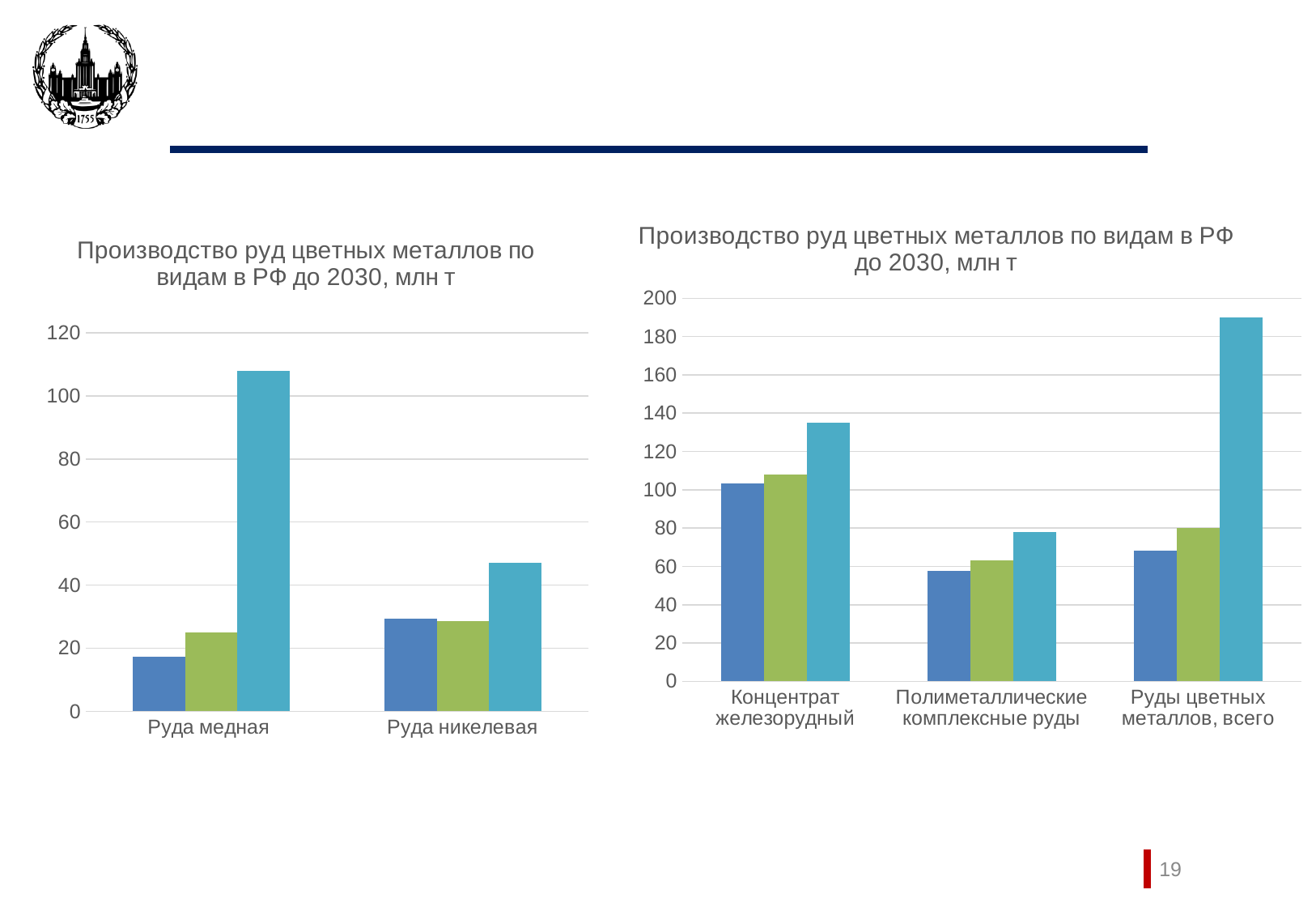
What kind of chart is the left chart on the slide? bar chart How many categories are shown on the x axis of the left chart? 2 In the right chart, which dark blue bar is larger: Концентрат железорудный or Полиметаллические комплексные руды? Концентрат железорудный How many bars are plotted for each category in the right chart? 3 How many categories are shown on the x axis of the right chart? 3 In the left chart, does the light blue bar rise or fall from Руда медная to Руда никелевая? fall In the left chart, is the value of the dark blue bar for Руда никелевая greater or less than 40? less In the right chart, which category has the tallest bar? Руды цветных металлов, всего In the right chart, is the value of the dark blue bar for Полиметаллические комплексные руды greater or less than 80? less In the right chart, is the value of the light blue bar for Руды цветных металлов, всего greater or less than 180? greater What is the title of the right chart? Производство руд цветных металлов по видам в РФ до 2030, млн т